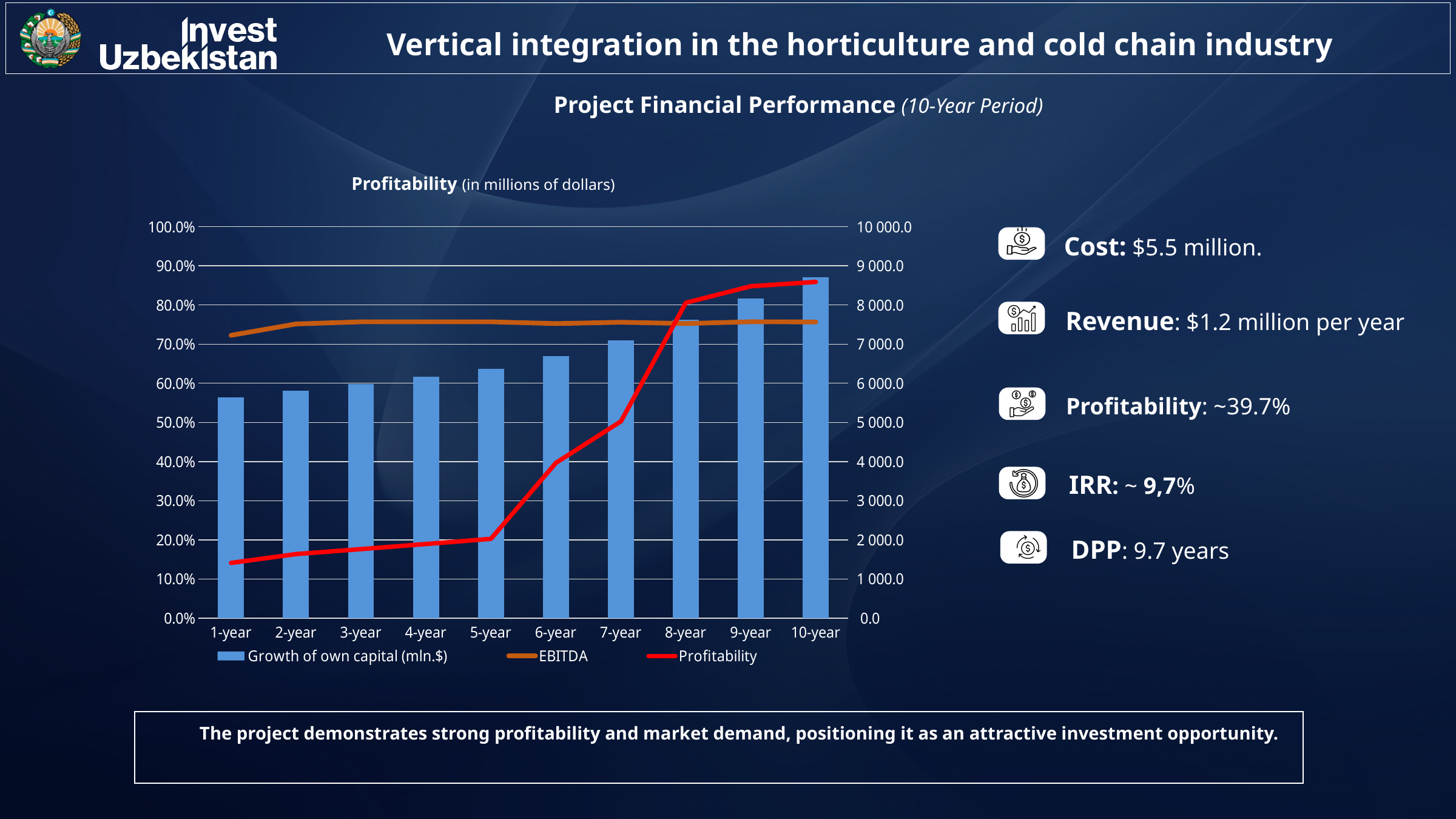
How many series does the chart legend list? 3 Which series is shown as bars in the chart? Growth of own capital (mln.$) How many year categories are shown on the x axis of the chart? 10 Which year has the tallest Growth of own capital bar? 10-year Which year has the shortest Growth of own capital bar? 1-year Is the Profitability value for 1-year greater or less than 20%? less Does the Profitability line rise or fall from 1-year to 10-year? Rise Which is larger, the Growth of own capital bar for 10-year or for 1-year? 10-year Do the Growth of own capital bars rise or fall from 1-year to 10-year? Rise What kind of chart is shown on the slide? A combined bar and line chart What colour is the Profitability line in the chart? Red Is the Profitability value for 10-year greater or less than 80%? greater